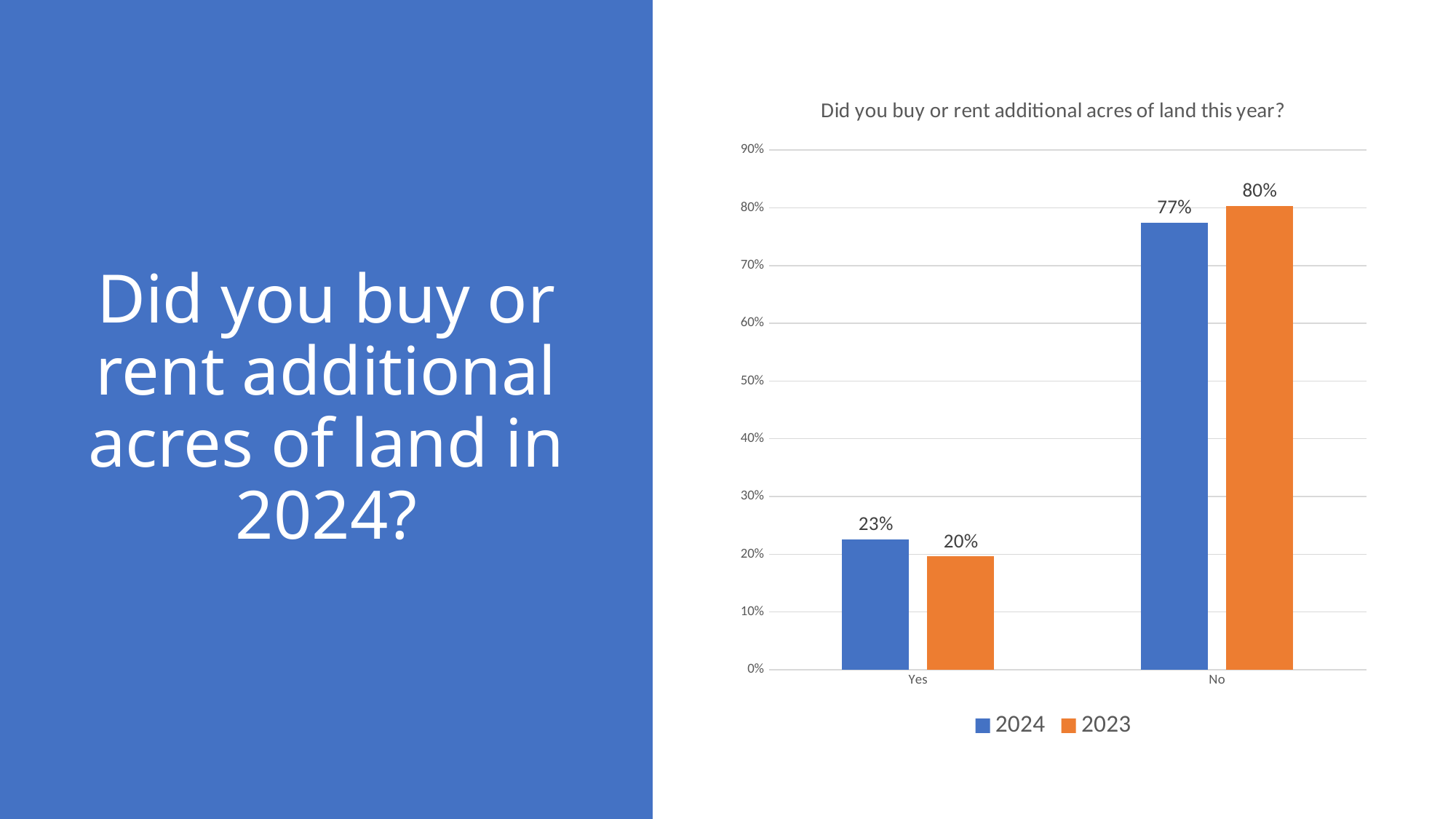
What kind of chart is shown on the slide? Bar chart What percentage answered No in 2023? 80% Which response category has the lowest value for the 2023 series? Yes What percentage answered Yes in 2024? 23% What is the difference between the 2023 and 2024 values for No? 3% Which year has the larger value for Yes, 2024 or 2023? 2024 What percentage answered Yes in 2023? 20% Which response category has the highest value for the 2024 series? No What percentage answered No in 2024? 77% What is the title of the chart? Did you buy or rent additional acres of land this year? How many series does the legend list? 2 How many response categories are shown on the x axis? 2